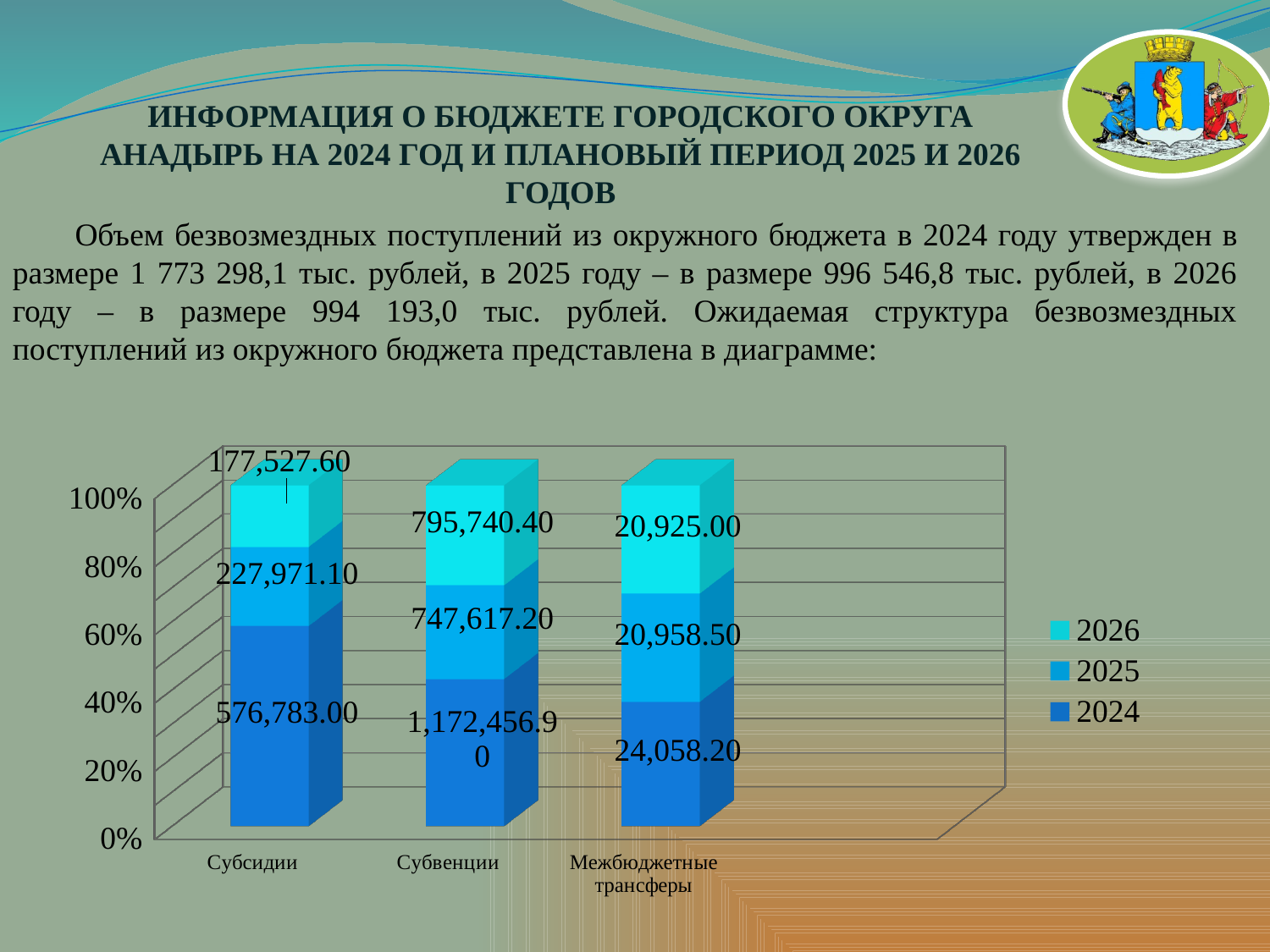
Which category has the lowest value for 2026? Межбюджетные трансферы What is the value for 2025 in the Межбюджетные трансферы category? 20,958.50 Which legend entry is shown in the lightest (cyan) colour? 2026 Which category has the highest value for 2024? Субвенции How many series does the chart legend list? 3 What is the difference between the 2024 and 2025 values in the Субсидии category? 348,811.90 What type of chart is shown on the slide? stacked bar chart What is the total of the three labelled values in the Межбюджетные трансферы bar? 65,941.70 How many categories are shown on the x axis of the chart? 3 What is the value for 2026 in the Субвенции category? 795,740.40 Which is larger in the Субвенции category: the 2025 value or the 2026 value? 2026 What is the value for 2024 in the Субсидии category? 576,783.00